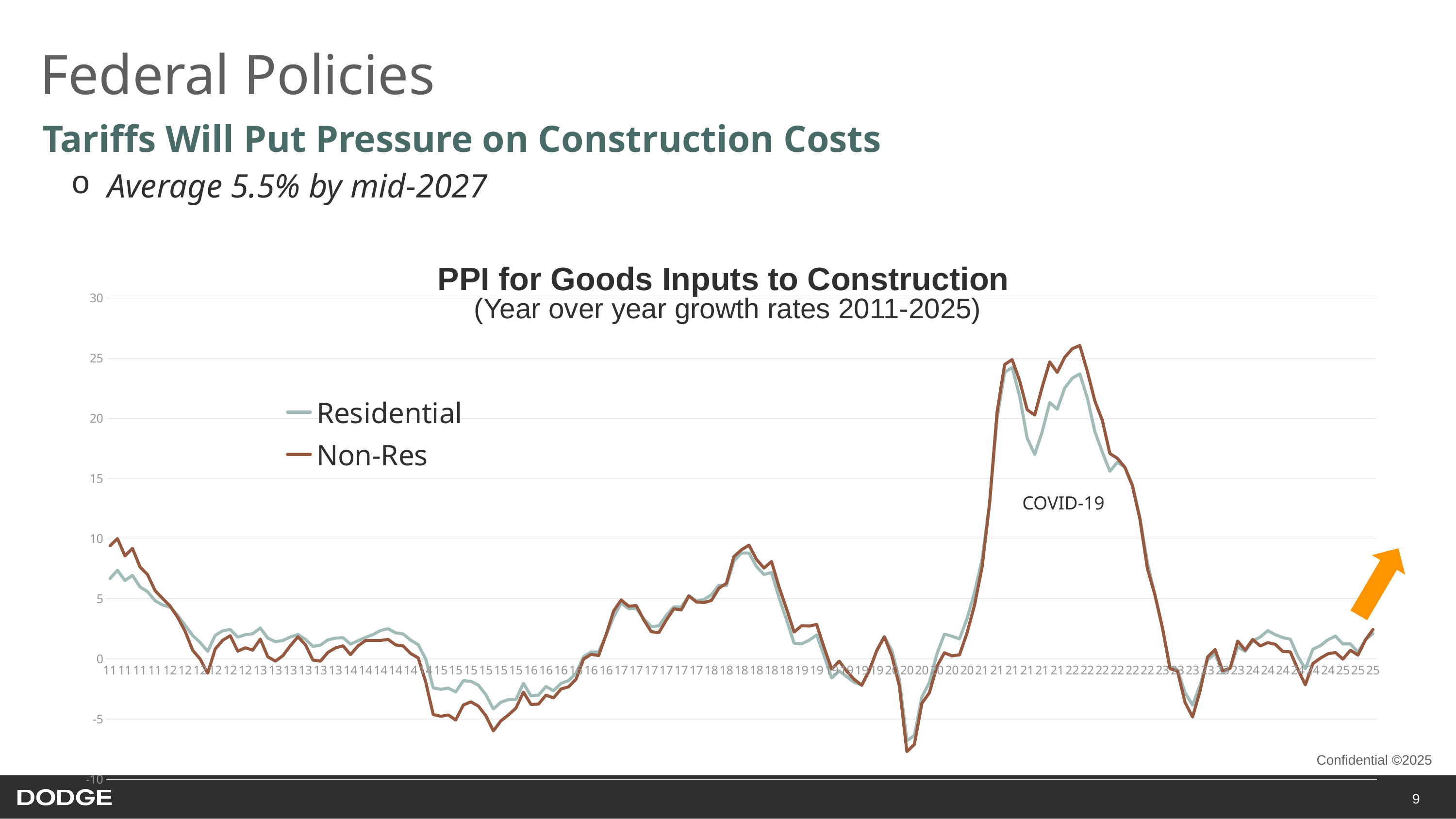
What are the two series named in the legend of the PPI chart? Residential and Non-Res How many series does the legend of the PPI chart list? 2 Which series reaches the highest value on the chart? Non-Res Which series reaches the lowest value on the chart? Non-Res Do the values rise or fall from the 2021-2022 peak through 2023? fall Is the peak value of the Residential series greater or less than 20? greater What is the highest value shown on the y axis of the chart? 30 Is the peak value of the Non-Res series greater or less than 20? greater At the COVID-19 peak, which series is higher, Residential or Non-Res? Non-Res What kind of chart is shown on the slide? line chart What is the title of the chart on the slide? PPI for Goods Inputs to Construction Is the lowest value of the Non-Res series (around 2020) greater or less than -5? less